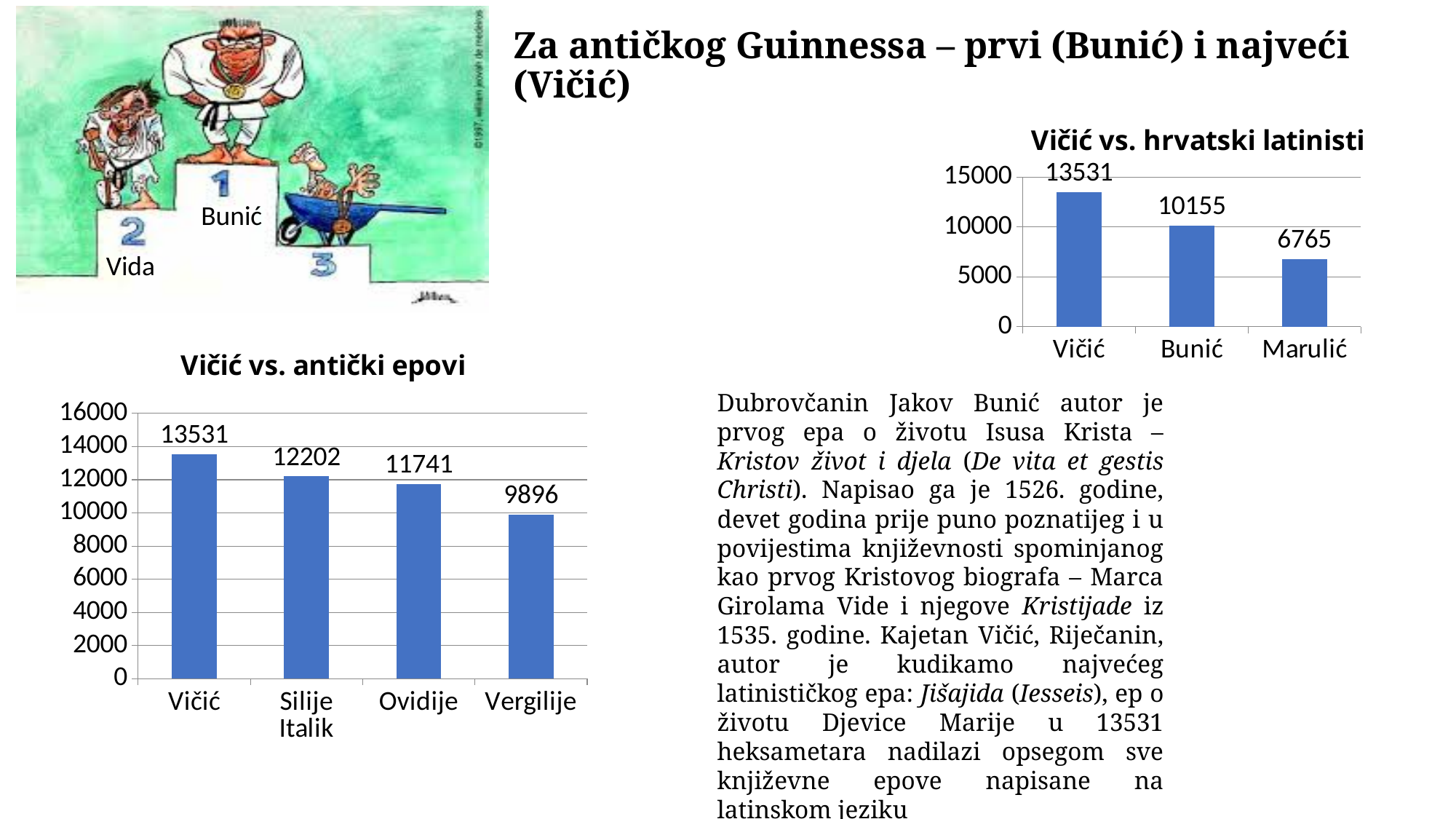
In the chart 'Vičić vs. antički epovi', do the values rise or fall from left to right along the x axis? fall In the chart 'Vičić vs. hrvatski latinisti', which category has the highest value? Vičić What kind of chart is 'Vičić vs. hrvatski latinisti'? bar chart In the chart 'Vičić vs. hrvatski latinisti', what is the value for Bunić? 10155 In the chart 'Vičić vs. antički epovi', which category has the lowest value? Vergilije In the chart 'Vičić vs. hrvatski latinisti', what is the value for Marulić? 6765 In the chart 'Vičić vs. hrvatski latinisti', what is the difference between the values for Bunić and Marulić? 3390 In the chart 'Vičić vs. antički epovi', what is the difference between the values for Vičić and Silije Italik? 1329 In the chart 'Vičić vs. hrvatski latinisti', which is larger, the value for Bunić or the value for Marulić? Bunić In the chart 'Vičić vs. antički epovi', what is the value for Ovidije? 11741 In the chart 'Vičić vs. antički epovi', what is the value for Vergilije? 9896 In the chart 'Vičić vs. antički epovi', how many categories are shown? 4